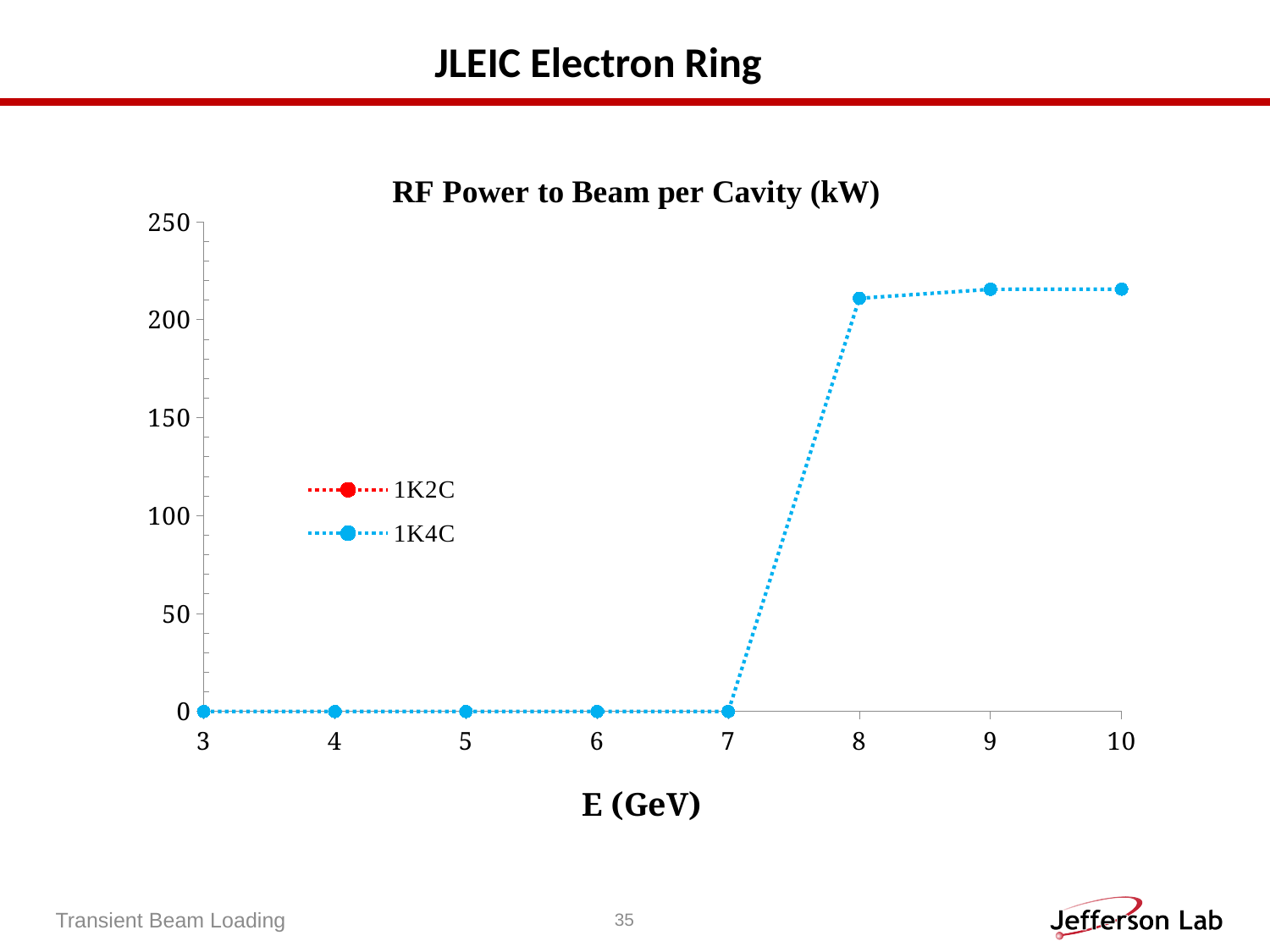
Is the 1K4C value at 10 GeV greater or less than 150? greater What is the title of the chart? RF Power to Beam per Cavity (kW) Is the 1K4C value at 9 GeV greater or less than 250? less Which has the larger 1K4C value, 5 GeV or 10 GeV? 10 GeV Is the 1K4C value at 6 GeV greater or less than 50? less Do the 1K4C values rise or fall as E increases from 7 GeV to 8 GeV? rise Which has the larger 1K4C value, 7 GeV or 8 GeV? 8 GeV What kind of chart is shown on the slide? line chart What is the label of the x axis? E (GeV) How many series does the legend list? 2 How many data points are plotted for the 1K4C series? 8